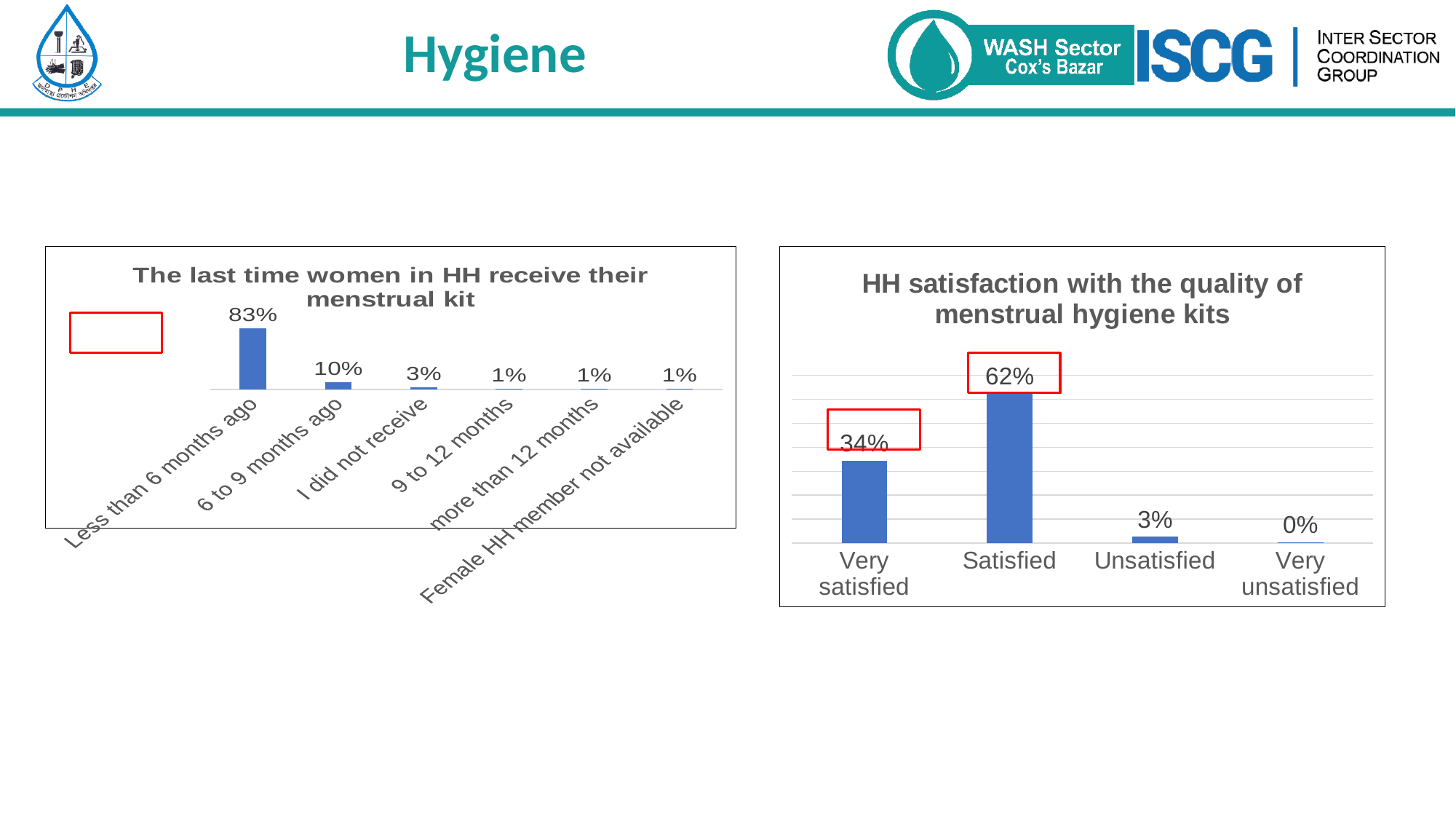
In the chart 'HH satisfaction with the quality of menstrual hygiene kits', what is the difference between 'Satisfied' and 'Unsatisfied'? 59% In the chart 'The last time women in HH receive their menstrual kit', what is the difference between 'Less than 6 months ago' and '6 to 9 months ago'? 73% In the chart 'The last time women in HH receive their menstrual kit', which category has the highest value? Less than 6 months ago In the chart 'The last time women in HH receive their menstrual kit', how many categories are shown? 6 In the chart 'The last time women in HH receive their menstrual kit', what is the value for 'I did not receive'? 3% In the chart 'HH satisfaction with the quality of menstrual hygiene kits', what is the value for 'Very satisfied'? 34% In the chart 'HH satisfaction with the quality of menstrual hygiene kits', which category has the lowest value? Very unsatisfied In the chart 'The last time women in HH receive their menstrual kit', what is the value for 'Less than 6 months ago'? 83% In the chart 'The last time women in HH receive their menstrual kit', what is the value for '6 to 9 months ago'? 10% In the chart 'HH satisfaction with the quality of menstrual hygiene kits', what is the value for 'Satisfied'? 62% In the chart 'HH satisfaction with the quality of menstrual hygiene kits', which is larger: 'Very satisfied' or 'Satisfied'? Satisfied What type of chart is 'HH satisfaction with the quality of menstrual hygiene kits'? Bar chart